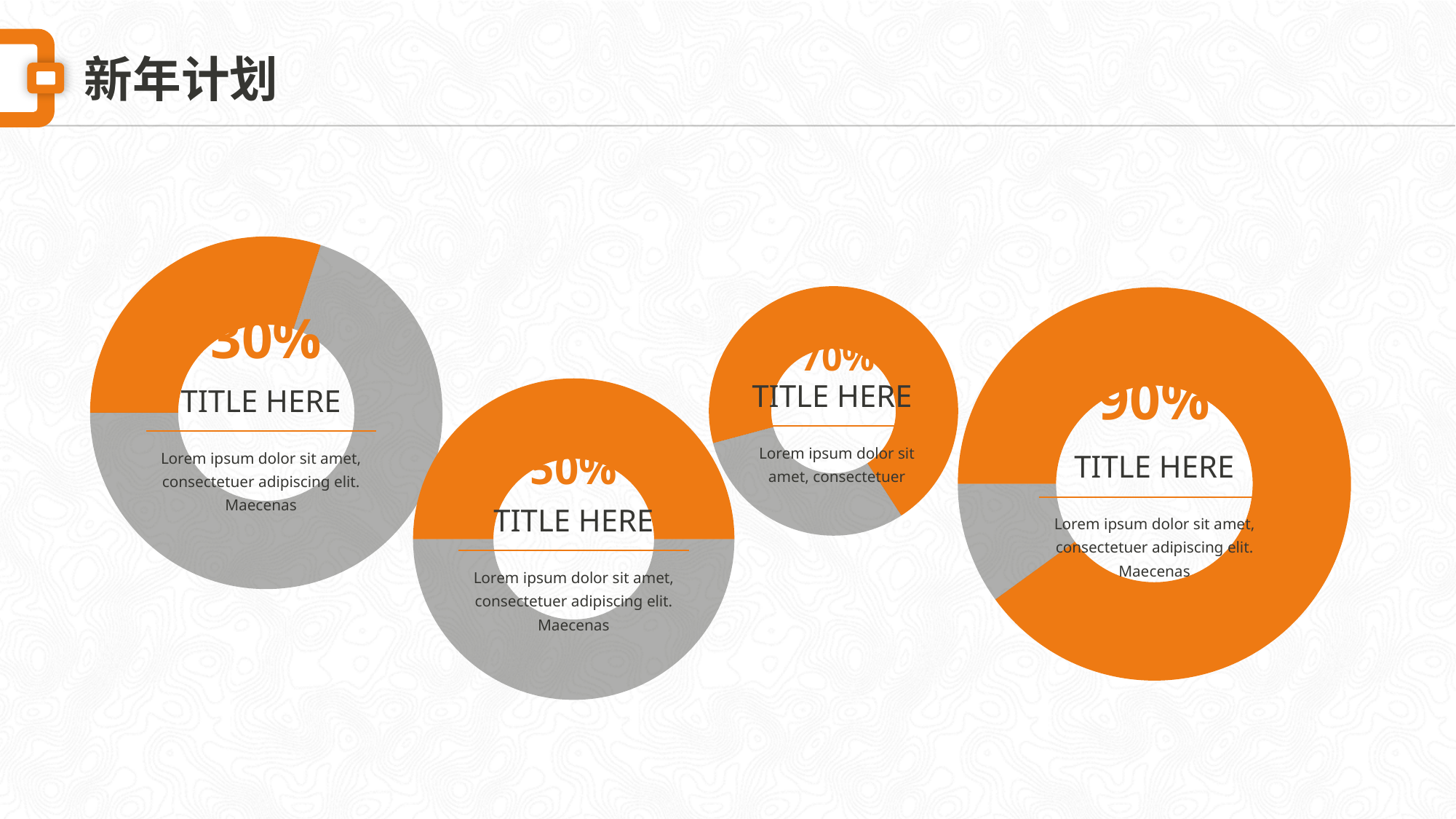
How many donut charts are shown on the slide? 4 What colour is used for the filled (percentage) portion of each donut chart? orange What percentage is shown in the rightmost donut chart? 90% Do the percentages in the donut charts rise or fall from left to right across the slide? rise Which donut chart shows the highest percentage? the rightmost chart (90%) What percentage is shown in the second donut chart from the left? 50% What is the difference between the percentage in the rightmost donut chart and the percentage in the leftmost donut chart? 60% What kind of chart is the leftmost chart on the slide? donut chart What percentage is shown in the leftmost donut chart? 30% Which donut chart shows the lowest percentage? the leftmost chart (30%) What percentage is shown in the third donut chart from the left? 70% Which is larger, the percentage in the second donut chart or the percentage in the third donut chart? the third chart (70%)